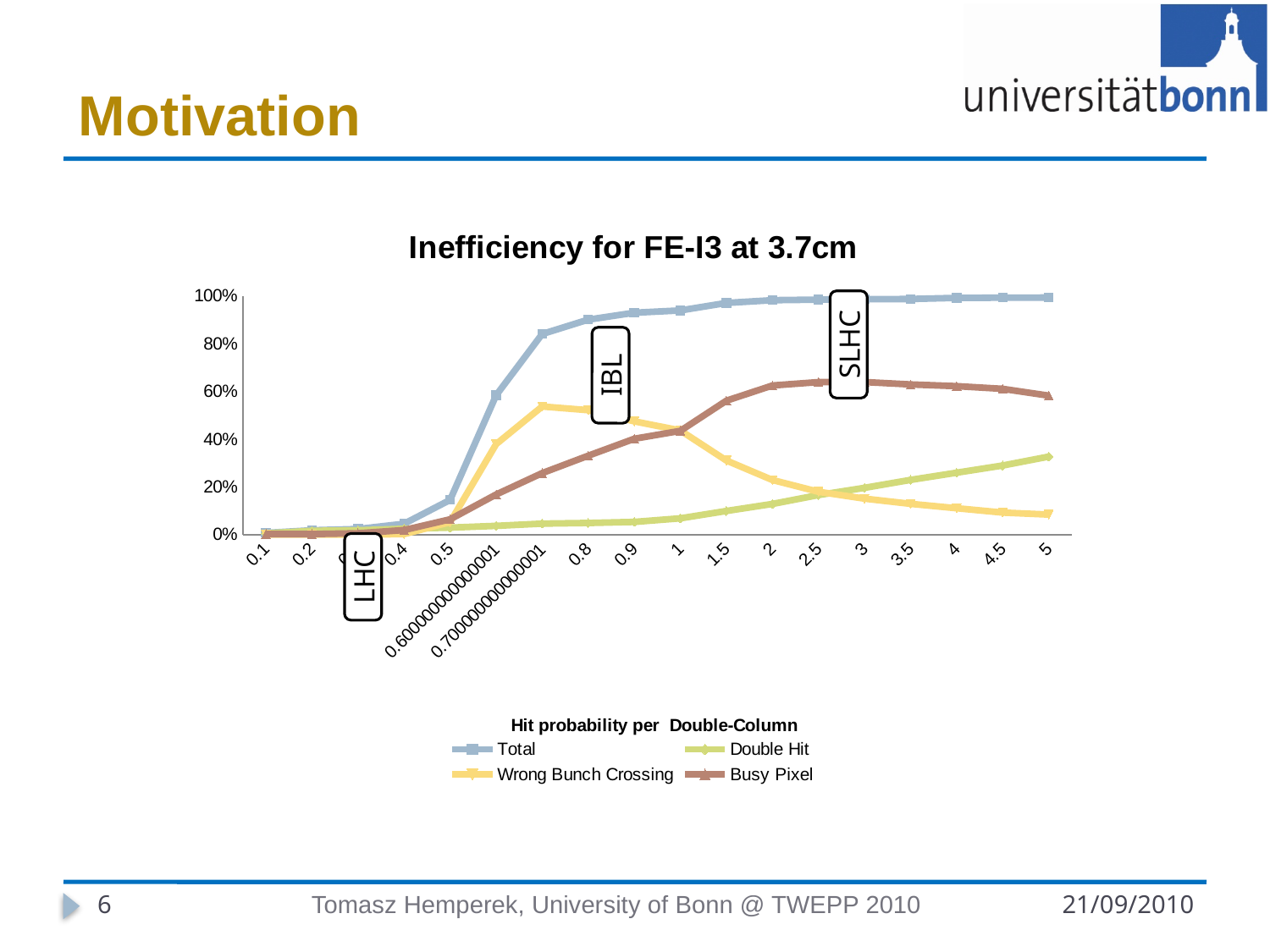
At 5, which series has the highest value? Total Is the value of the Busy Pixel series at 5 greater or less than 80%? less At 5, which series has the lowest value? Wrong Bunch Crossing How many series does the legend list? 4 Is the value of the Double Hit series at 5 greater or less than 20%? greater Is the value of the Total series at 5 greater or less than 80%? greater At 2, which is larger: Busy Pixel or Wrong Bunch Crossing? Busy Pixel What kind of chart is shown on the slide? Line chart What is the title of the chart? Inefficiency for FE-I3 at 3.7cm Does the Total series rise or fall as the hit probability increases along the x axis? Rise What is the title shown above the legend? Hit probability per Double-Column